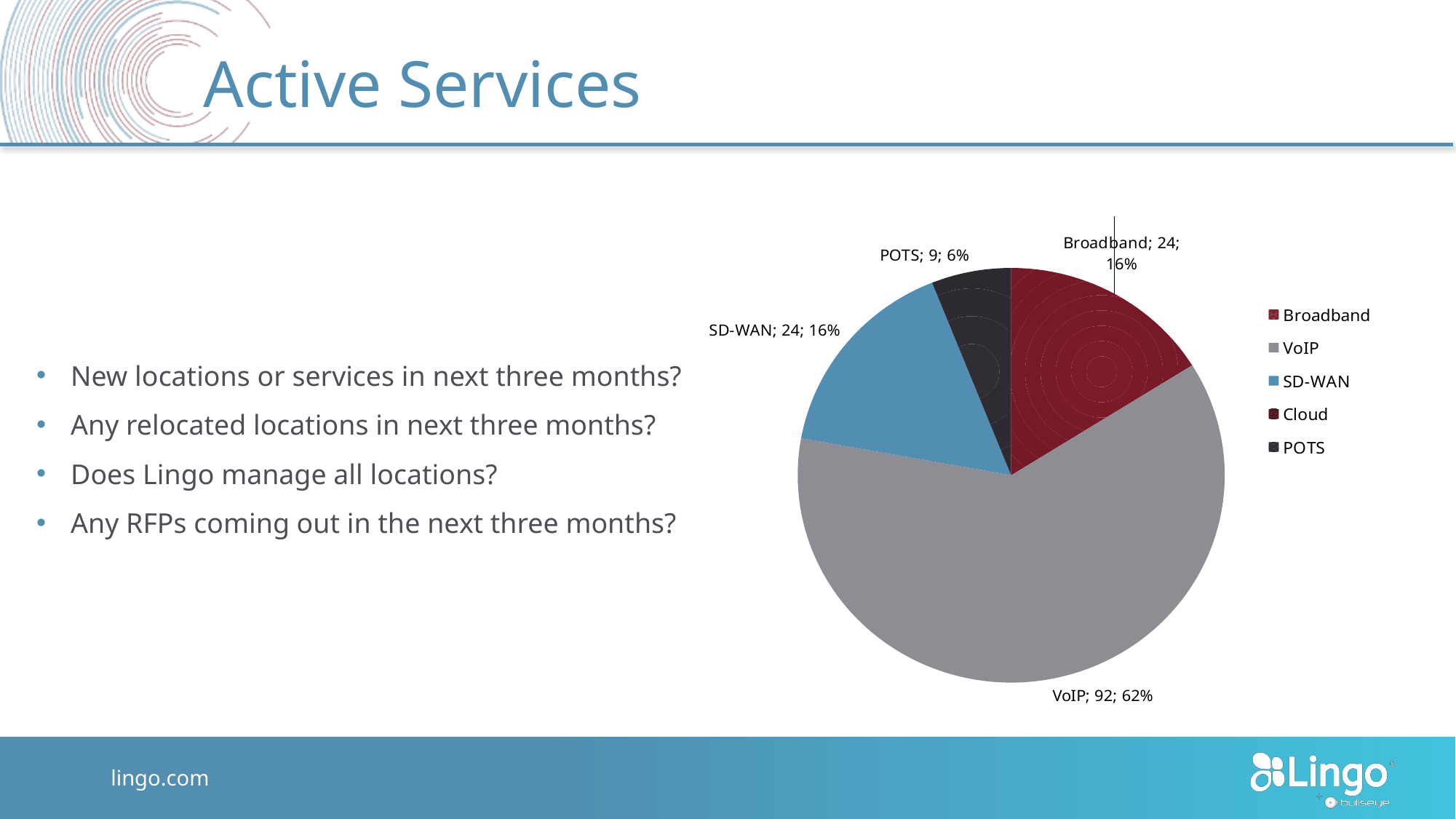
Which is larger, the value for VoIP or the value for POTS? VoIP What is the value shown for POTS in the pie chart? 9 What percentage share does SD-WAN have in the pie chart? 16% Which category has the largest slice in the pie chart? VoIP Which labelled category has the smallest slice in the pie chart? POTS What percentage share does VoIP have in the pie chart? 62% What is the difference between the VoIP value and the Broadband value? 68 What type of chart is shown on the slide? pie chart What is the value shown for Broadband in the pie chart? 24 How many entries does the legend of the pie chart list? 5 What is the value shown for VoIP in the pie chart? 92 What percentage share does POTS have in the pie chart? 6%